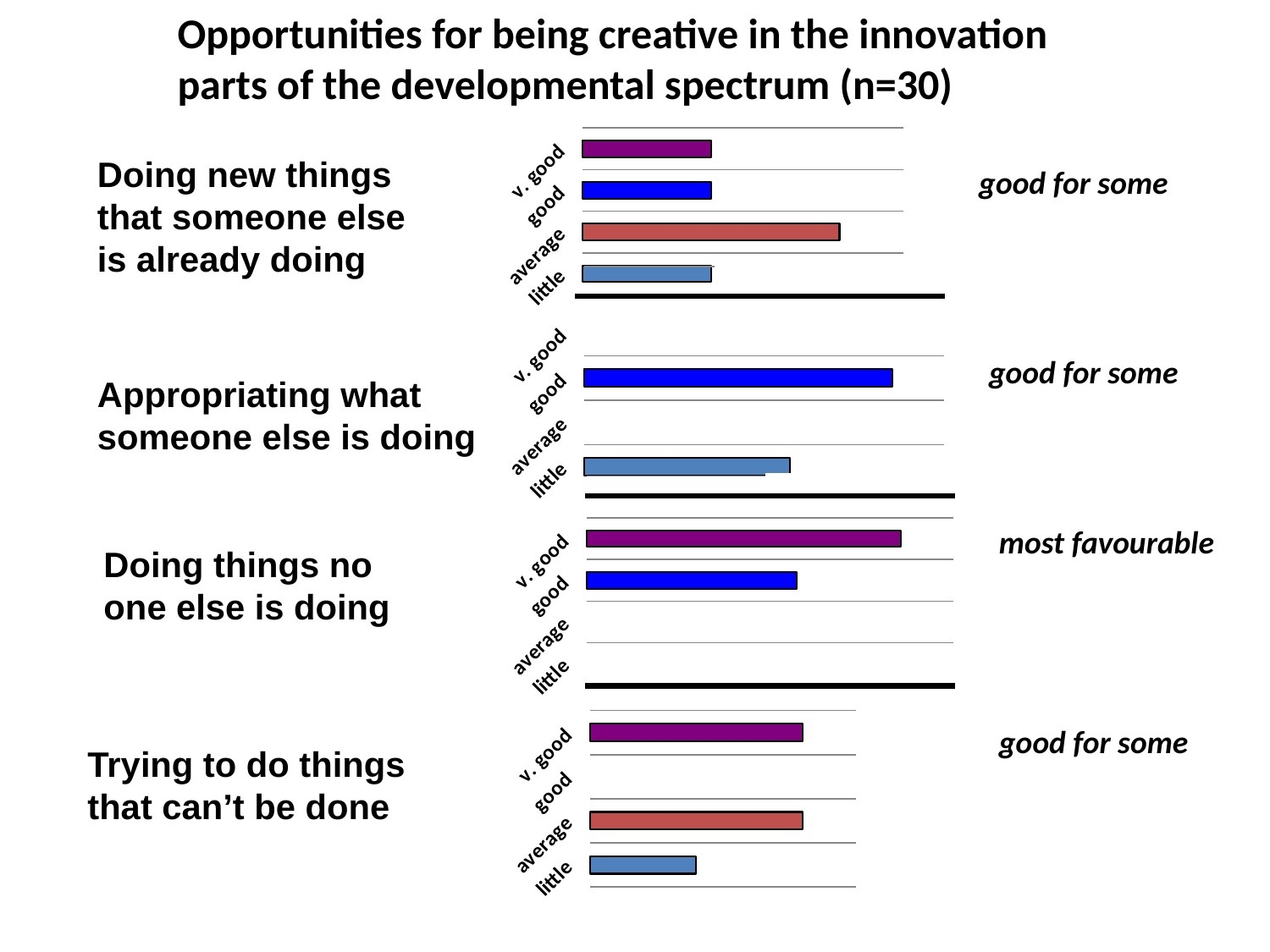
In the 'Appropriating what someone else is doing' chart, which bar is longer: good or little? good What sample size (n) is given in the slide title? n=30 In the 'Doing new things that someone else is already doing' chart, which bar is longer: average or little? average How many bars are plotted in the 'Appropriating what someone else is doing' chart? 2 In the 'Appropriating what someone else is doing' chart, which category has the longest bar? good How many categories are listed on the axis of the 'Doing things no one else is doing' chart? 4 Which chart on the slide is annotated as 'most favourable'? Doing things no one else is doing In the 'Doing new things that someone else is already doing' chart, which category has the longest bar? average In the 'Doing things no one else is doing' chart, which bar is longer: v. good or good? v. good What kind of chart is used for 'Doing new things that someone else is already doing'? bar chart In the 'Doing things no one else is doing' chart, which category has the longest bar? v. good In the 'Trying to do things that can't be done' chart, which of the plotted categories has the shortest bar? little